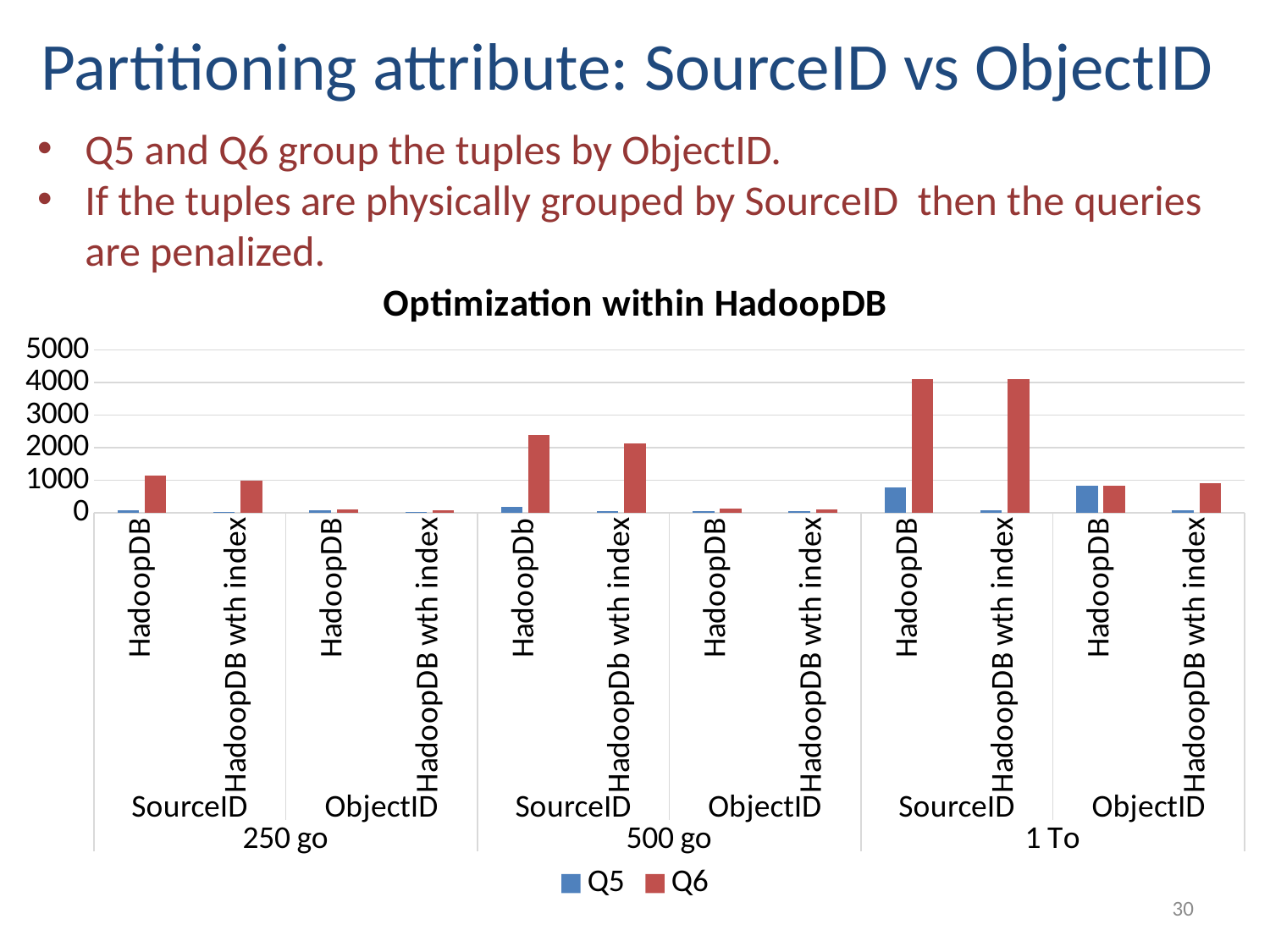
Which data size group has the highest Q6 values? 1 To How many data size groups are shown along the x axis? 3 Is the Q6 value for HadoopDB under SourceID at 250 go greater or less than 2000? less Which series are listed in the legend? Q5 and Q6 At 500 go, which partitioning attribute has the larger Q6 value for HadoopDB: SourceID or ObjectID? SourceID For HadoopDB under SourceID at 1 To, which is larger, Q5 or Q6? Q6 Is the Q5 value for HadoopDB under ObjectID at 1 To greater or less than 1000? less How many series does the legend list? 2 What is the title of the chart? Optimization within HadoopDB Is the Q6 value for HadoopDB under SourceID at 1 To greater or less than 3000? greater What type of chart is shown on the slide? bar chart